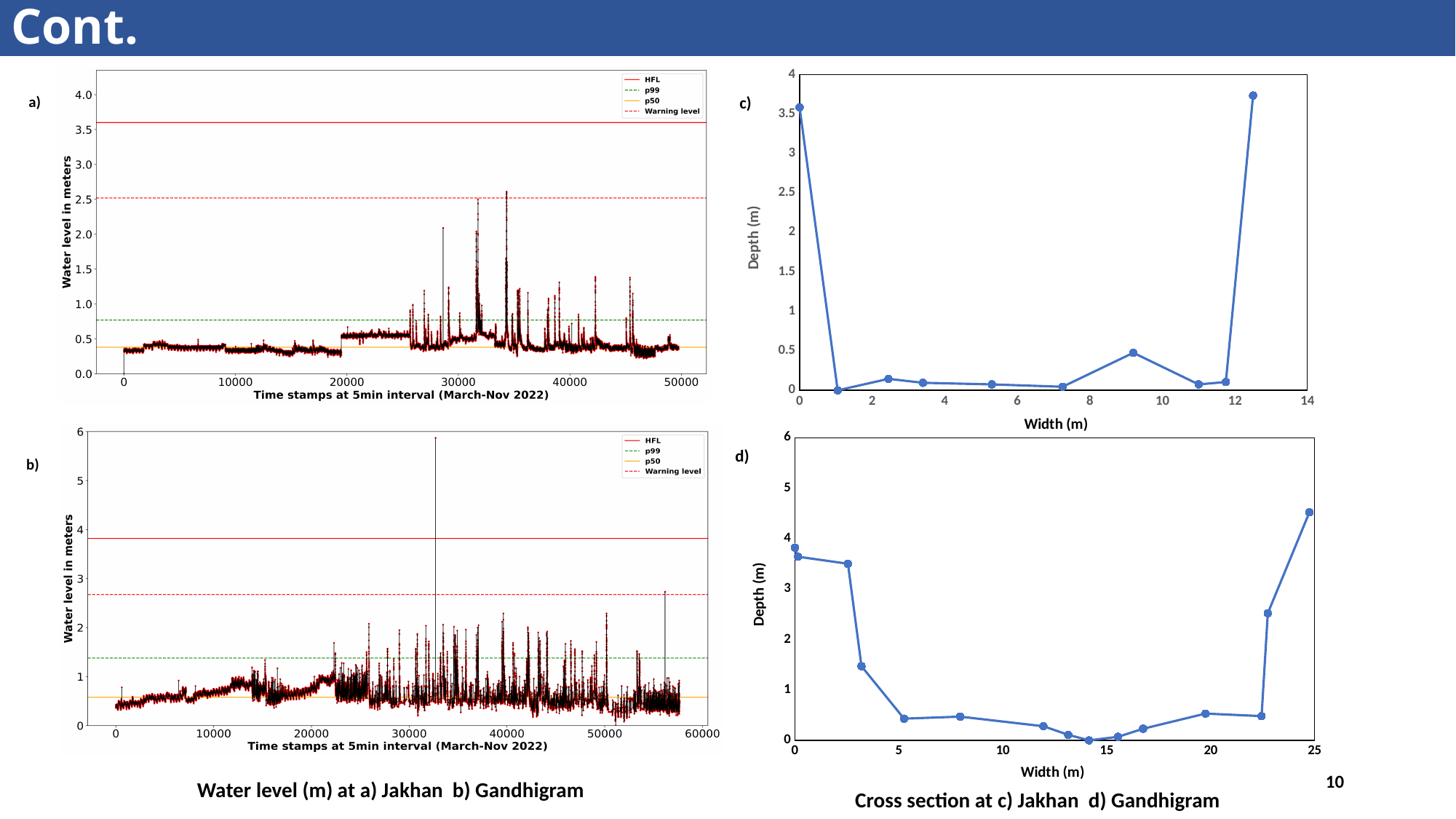
In chart a) (Water level at Jakhan), is the HFL line greater or less than 3.5? greater In chart d), is the depth at width 5 m greater or less than 1? less What is the x-axis label of chart d)? Width (m) What are the legend entries in chart b)? HFL, p99, p50, Warning level In chart d) (Cross section at Gandhigram), is the depth at the rightmost point greater or less than 4? greater In chart c), how does the depth change from width 0 m to width 1 m? It falls How many entries does the legend of chart a) list? 4 How many data points are plotted in chart c) (Cross section at Jakhan)? 10 In chart d), which is deeper: the leftmost point or the rightmost point? the rightmost point What kind of chart is chart c) (Cross section at Jakhan)? Line chart